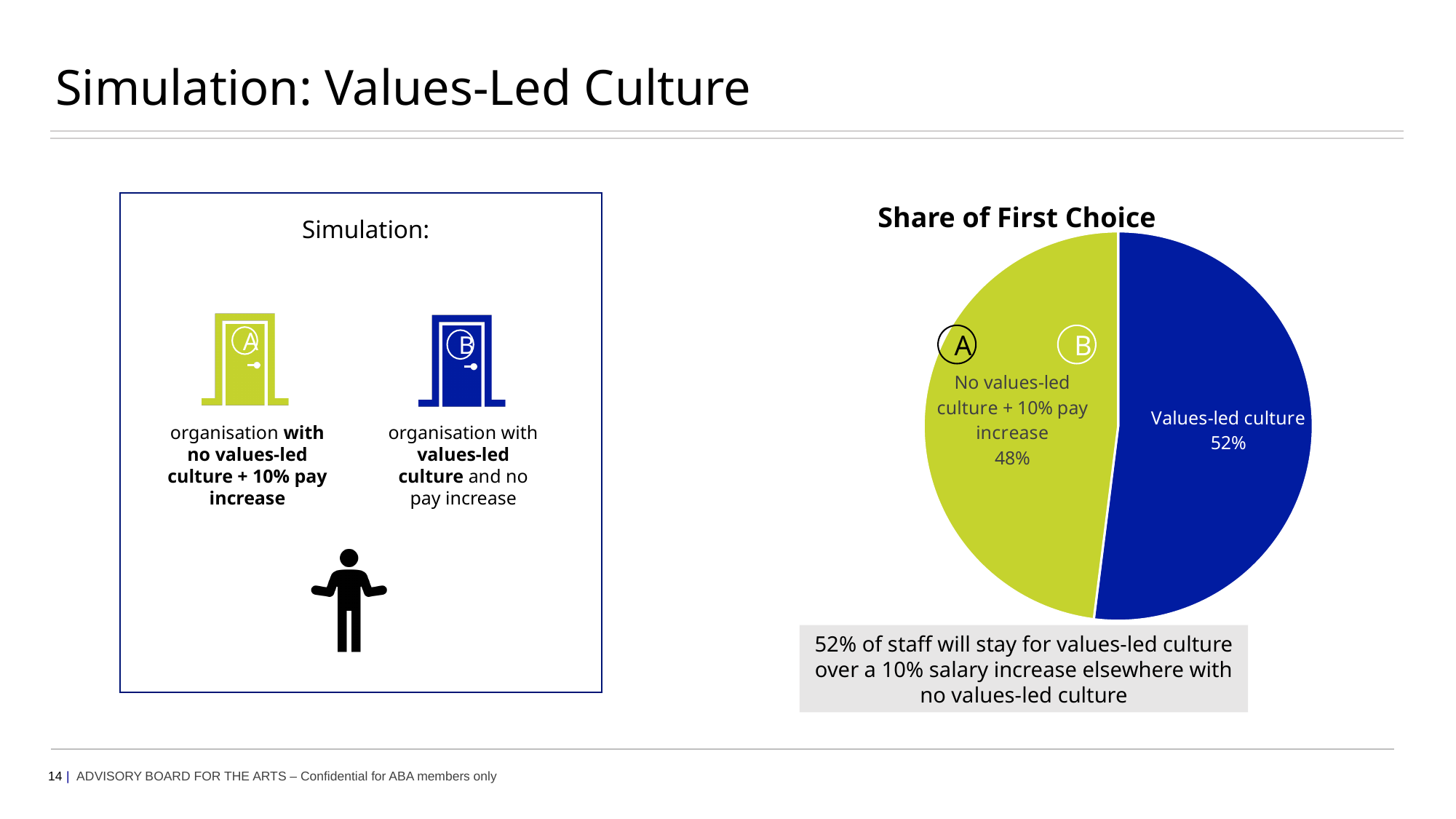
What kind of chart is shown on the slide? Pie chart Which slice of the pie chart is the smallest? No values-led culture + 10% pay increase Which slice of the pie chart is the largest? Values-led culture Which option letter is associated with the 'Values-led culture' slice? B Which is larger: the share for 'Values-led culture' or the share for 'No values-led culture + 10% pay increase'? Values-led culture What colour is the 'Values-led culture' slice of the pie chart? Blue What share of first choice does the 'No values-led culture + 10% pay increase' slice represent? 48% How many slices does the pie chart have? 2 What is the total of the two slices in the pie chart? 100% What is the title of the pie chart? Share of First Choice What is the difference in percentage points between the 'Values-led culture' slice and the 'No values-led culture + 10% pay increase' slice? 4 percentage points What share of first choice does the 'Values-led culture' slice represent? 52%